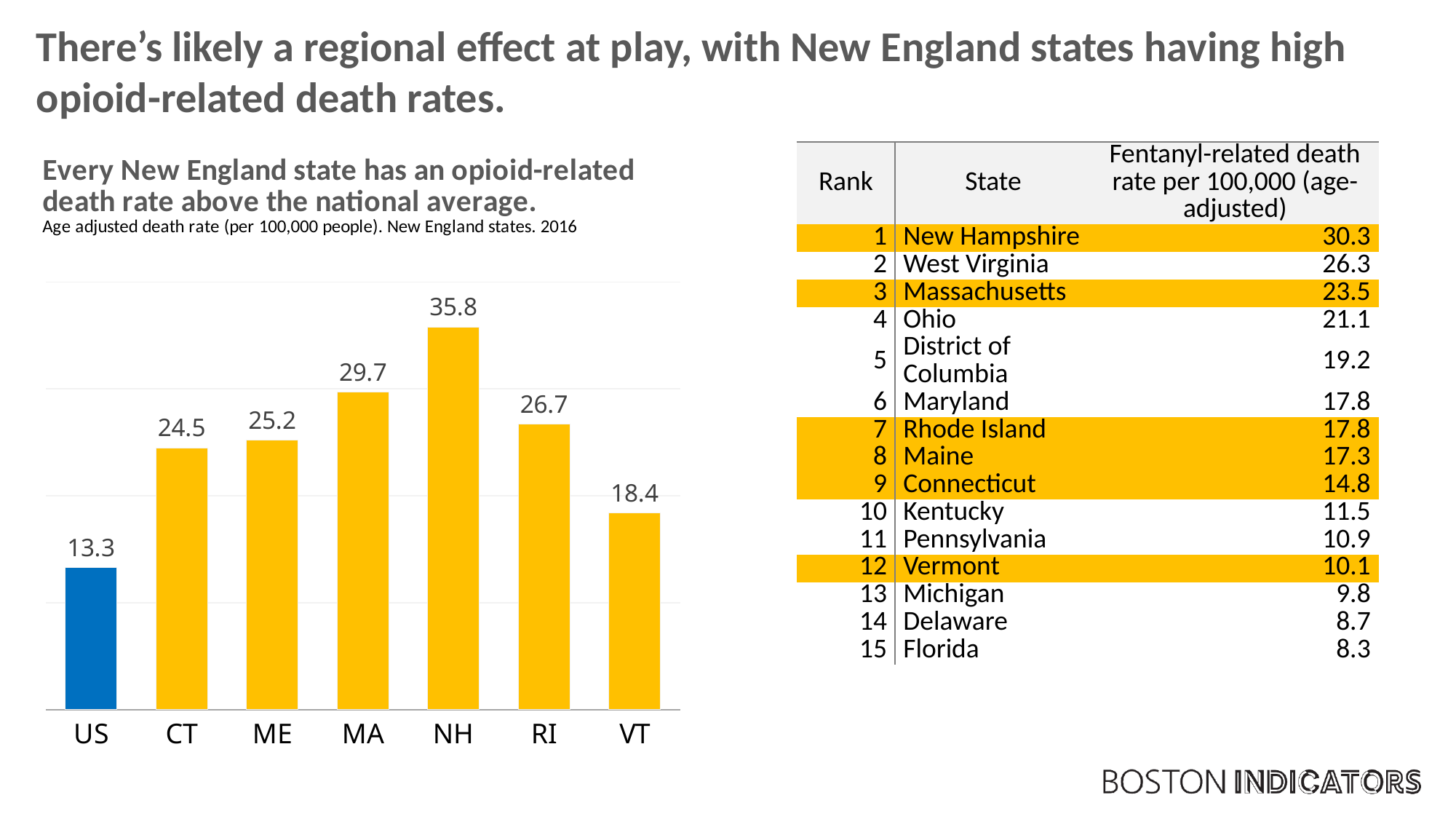
What is the age adjusted opioid-related death rate for the US in the bar chart? 13.3 Which category has the highest value in the bar chart? NH What is the title of the bar chart? Every New England state has an opioid-related death rate above the national average. How many categories are shown in the bar chart? 7 What is the value shown for MA in the bar chart? 29.7 In the bar chart, which bar is coloured blue rather than yellow? US What is the difference between the values for ME and CT in the bar chart? 0.7 Which category has the lowest value in the bar chart? US What is the difference between the values for NH and the US in the bar chart? 22.5 In the bar chart, which has a higher value, RI or VT? RI What is the age adjusted opioid-related death rate for NH in the bar chart? 35.8 What kind of chart is shown on the left of the slide? Bar chart